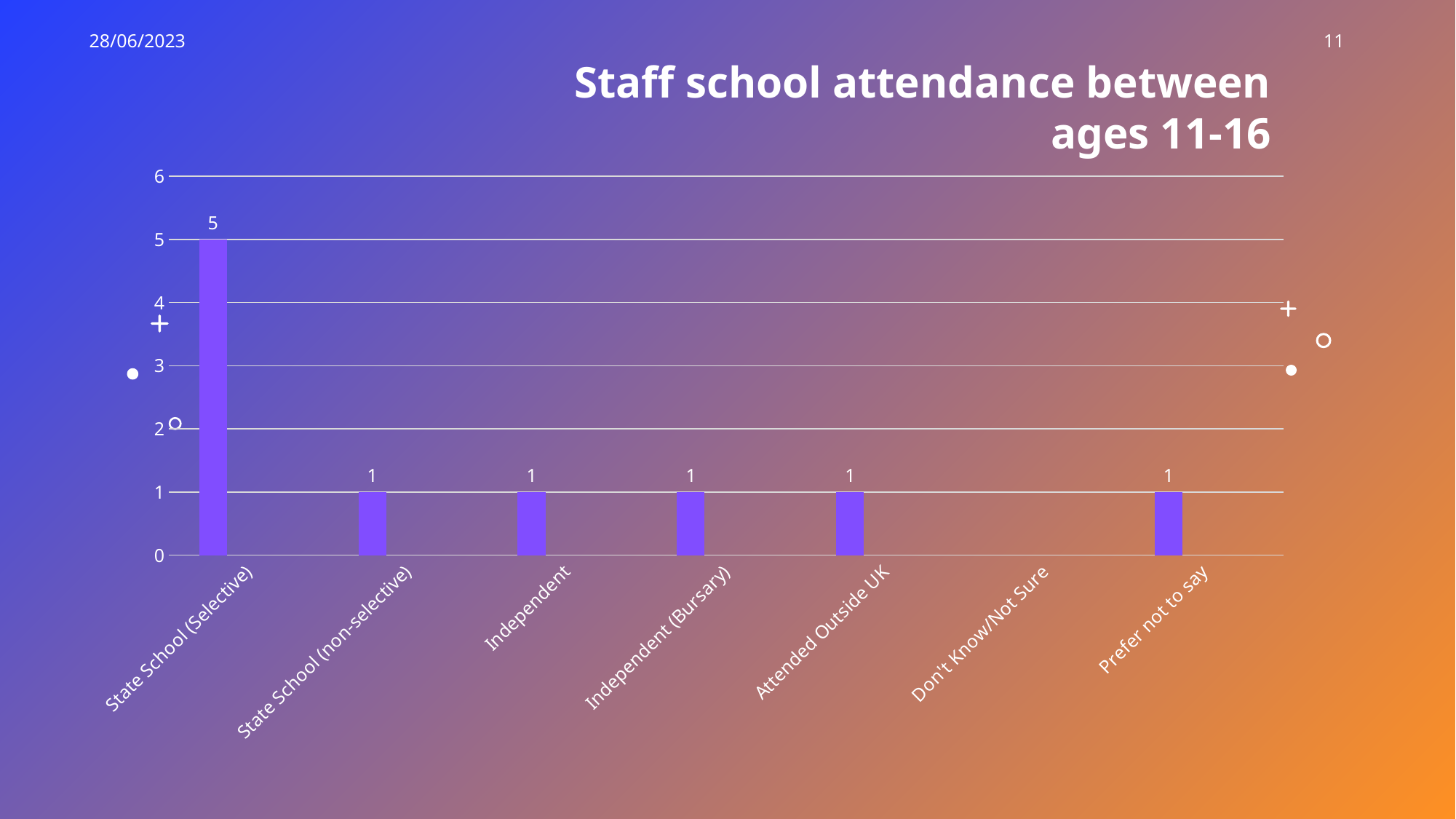
What kind of chart is shown on the slide? bar chart Which category has the highest value? State School (Selective) What is the value for Independent (Bursary)? 1 What is the value for State School (Selective)? 5 Which is larger, the value for State School (Selective) or the value for Attended Outside UK? State School (Selective) What is the difference between the values for State School (Selective) and Independent? 4 What is the value for Prefer not to say? 1 Is the value for State School (Selective) greater or less than 4? greater How many categories are shown on the x axis? 7 What is the title of the chart? Staff school attendance between ages 11-16